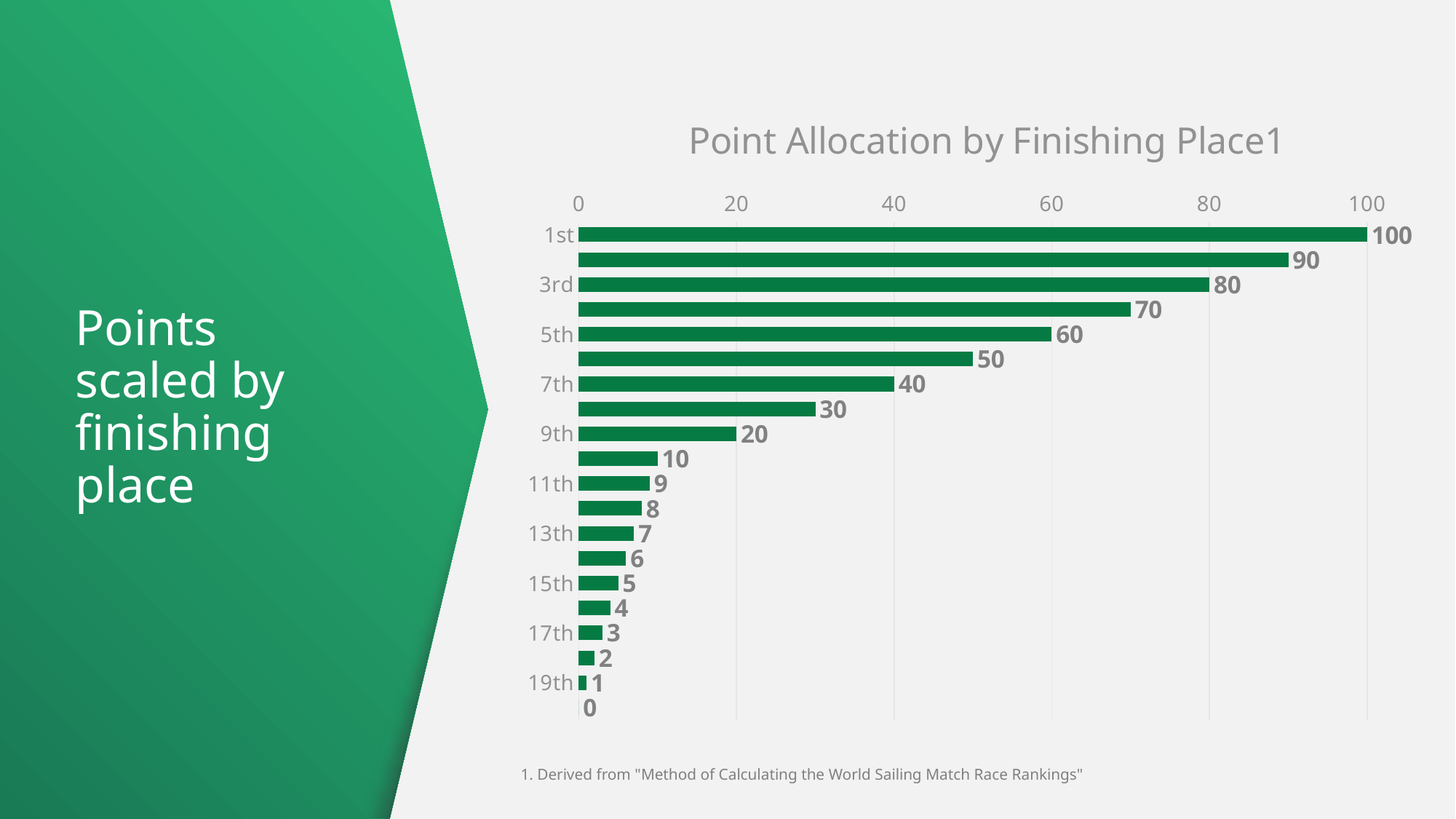
What is the difference in points between 3rd place and 7th place? 40 How many points are allocated for 5th place? 60 How many points are allocated for 19th place? 1 Which finishing place receives the most points? 1st How many points are allocated for 1st place? 100 How many bars are plotted in the chart? 20 What is the title of the chart? Point Allocation by Finishing Place1 How many points are allocated for 13th place? 7 Do the point values rise or fall as the finishing place goes from 1st down to 19th? Fall How many points are allocated for 9th place? 20 What type of chart is shown on the slide? Bar chart Which receives more points, 11th place or 15th place? 11th